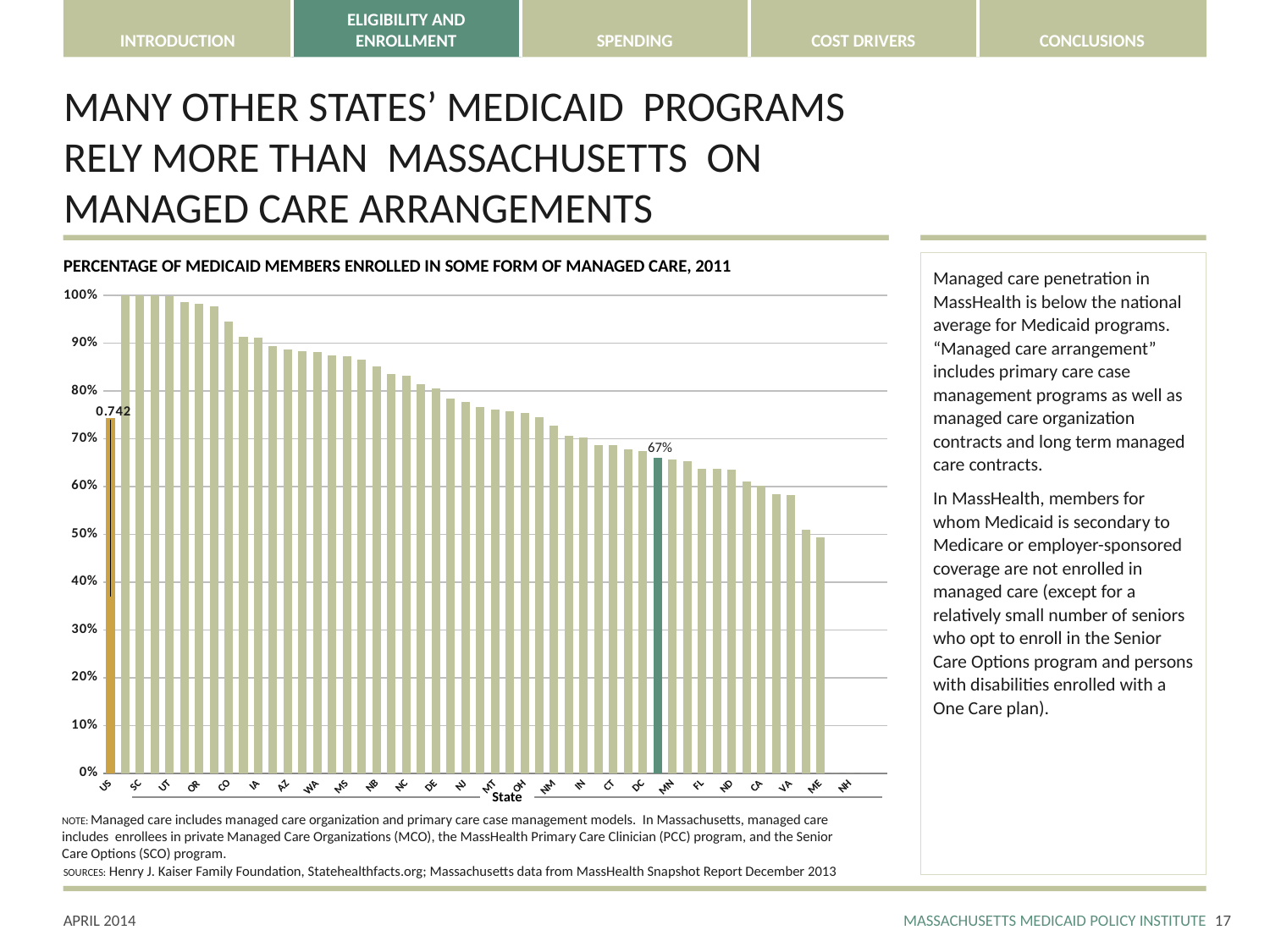
What value is printed on the US bar? 0.742 Is the value for ME greater or less than 60%? less Do the state bars rise or fall moving from left to right along the x axis? Fall Is the value for MS greater or less than 80%? greater What is the label on the x axis of the chart? State What is the title of the chart? Percentage of Medicaid members enrolled in some form of managed care, 2011 Is the value for CO greater or less than 90%? greater What kind of chart is shown on the slide? Bar chart Which is larger, the US bar or the dark green highlighted bar? US Which is larger, the value for SC or the value for ME? SC What value is printed on the dark green highlighted bar? 67%